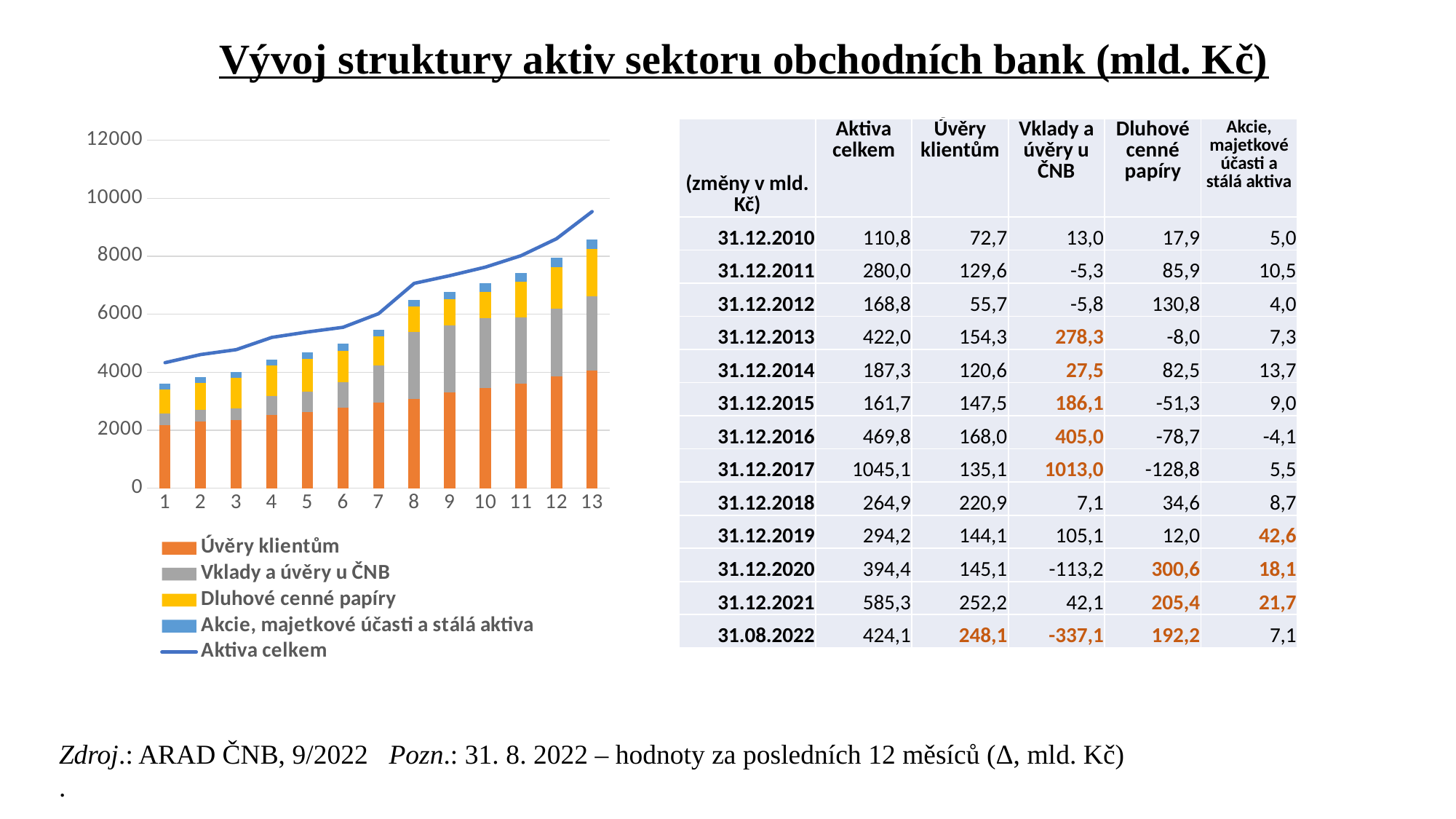
Which series in the chart is drawn as a line rather than bars? Aktiva celkem At which category is the Aktiva celkem line highest? 13 Which is larger: the Úvěry klientům segment at category 13 or at category 1? Category 13 What kind of chart is shown on the slide? Stacked bar chart with a line Is the value of the Aktiva celkem line at category 1 greater or less than 4000? greater At which category is the Aktiva celkem line lowest? 1 Is the total height of the stacked bar at category 1 greater or less than 4000? less How many categories are shown on the x axis of the chart? 13 Is the value of the Aktiva celkem line at category 13 greater or less than 8000? greater Does the Aktiva celkem line rise or fall from category 1 to category 13? Rises How many series does the chart legend list? 5